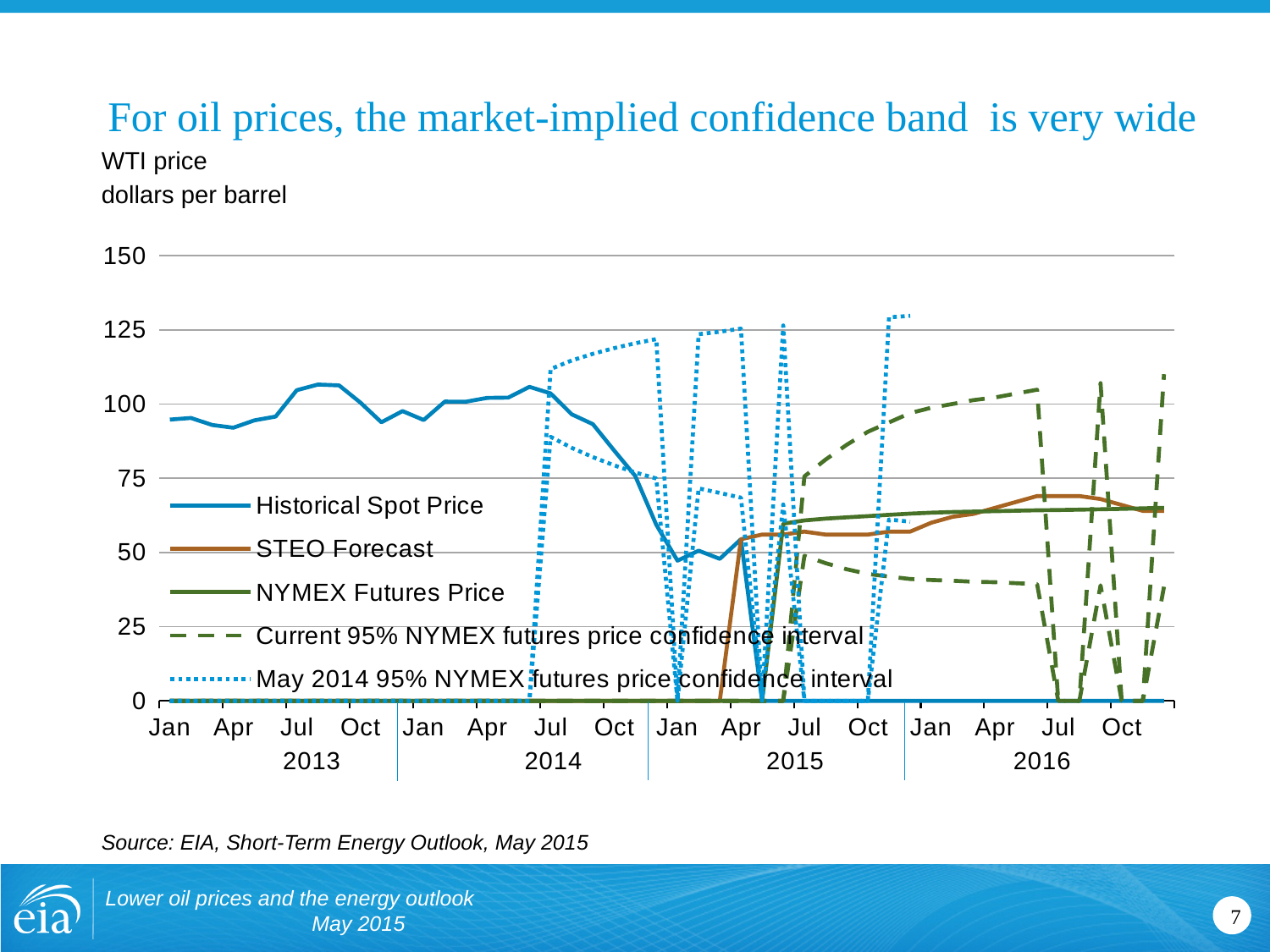
Which series is drawn with a dotted line according to the legend? May 2014 95% NYMEX futures price confidence interval Does the Historical Spot Price rise or fall between Jul 2014 and Jan 2015? fall Is the Historical Spot Price in Jan 2013 greater or less than the Historical Spot Price in Jan 2015? greater How many series does the legend list? 5 How many years are labelled on the x axis? 4 Is the STEO Forecast in Jul 2016 greater or less than 50? greater What kind of chart is shown on the slide? line chart What unit is the WTI price plotted in? dollars per barrel Is the Historical Spot Price in Jan 2013 greater or less than 75? greater Is the Historical Spot Price in Jan 2015 greater or less than 75? less What is the highest value shown on the y axis? 150